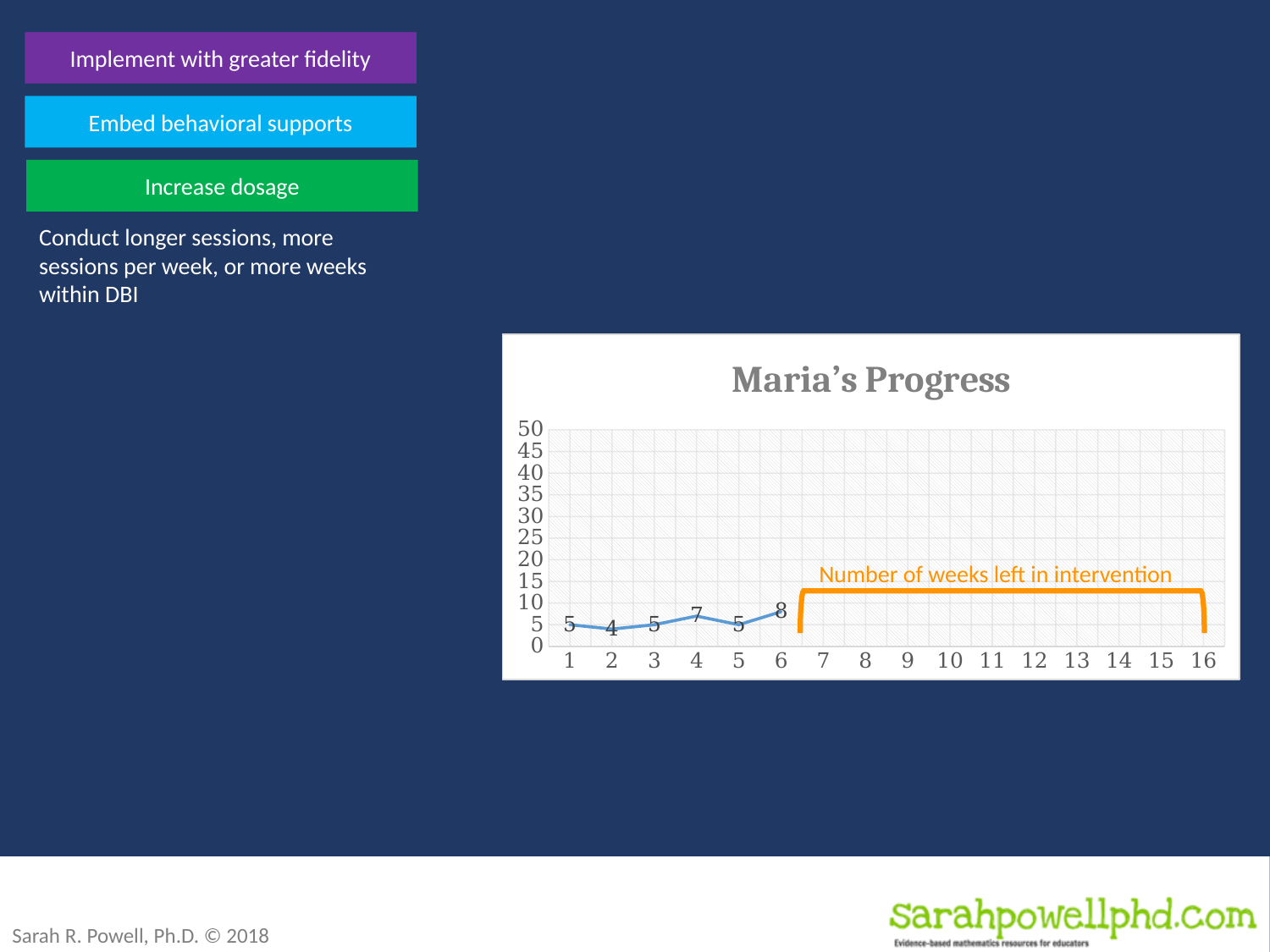
What is the value plotted at week 6? 8 What is the value plotted at week 4? 7 What is the value plotted at week 1? 5 What is the value plotted at week 2? 4 Which is larger, the value at week 4 or the value at week 5? week 4 What is the title of the chart? Maria's Progress At which week is the plotted value highest? 6 What does the orange bracket on the chart indicate? Number of weeks left in intervention At which week is the plotted value lowest? 2 How many data points are plotted on the line? 6 What is the difference between the values at week 6 and week 2? 4 What type of chart is shown on the slide? line chart